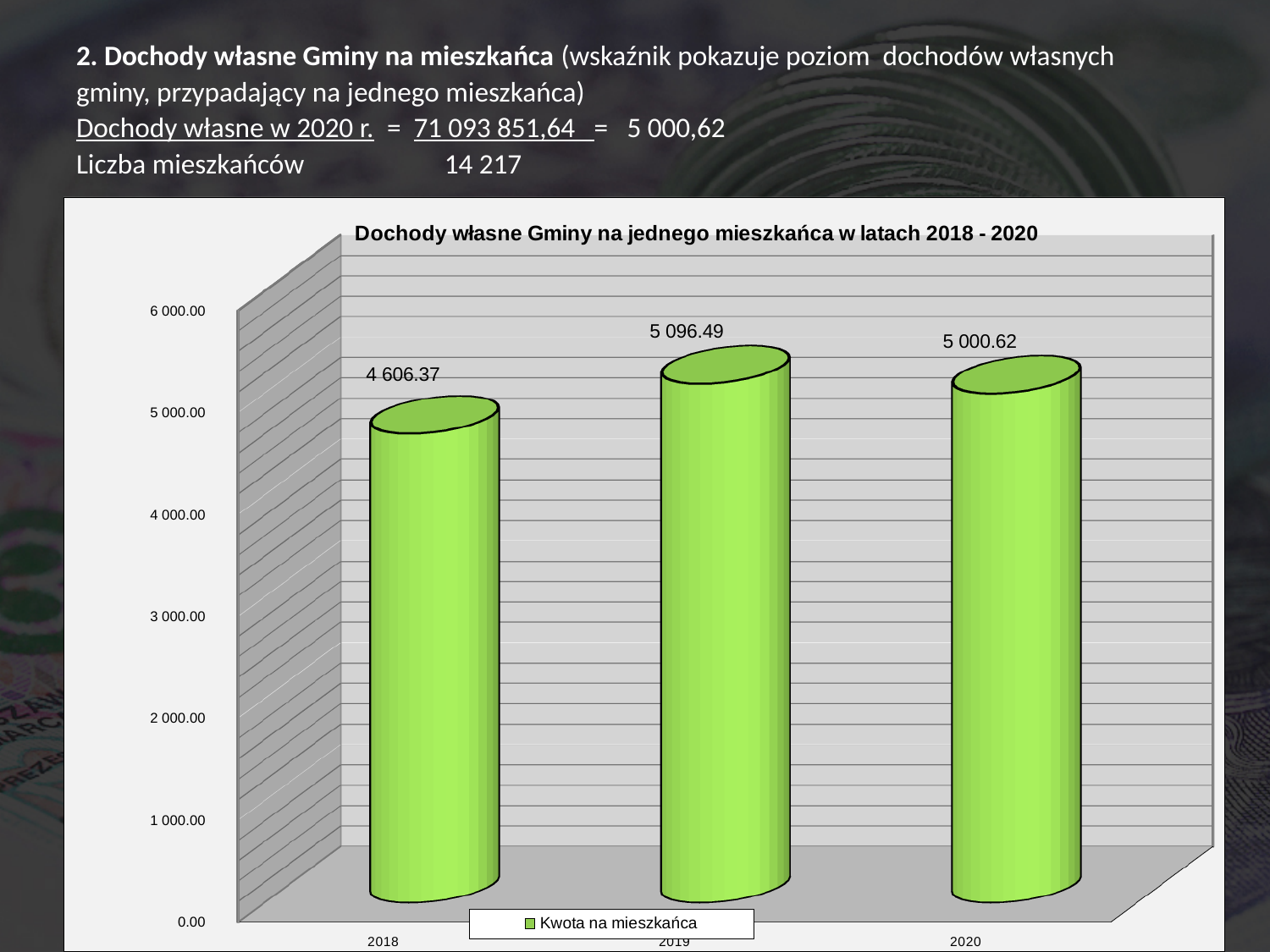
What is the difference between the values for 2019 and 2018? 490.12 What is the value for 2020 in the chart? 5 000.62 What is the value for 2018 in the chart? 4 606.37 How many years are shown in the chart? 3 What is the value for 2019 in the chart? 5 096.49 What is the title of the chart? Dochody własne Gminy na jednego mieszkańca w latach 2018 - 2020 What kind of chart is shown on the slide? bar chart Is the value for 2018 greater or less than 5 000.00? less Which year has the highest value in the chart? 2019 What is the difference between the values for 2019 and 2020? 95.87 Which year has the lowest value in the chart? 2018 Which is larger, the value for 2020 or the value for 2018? 2020